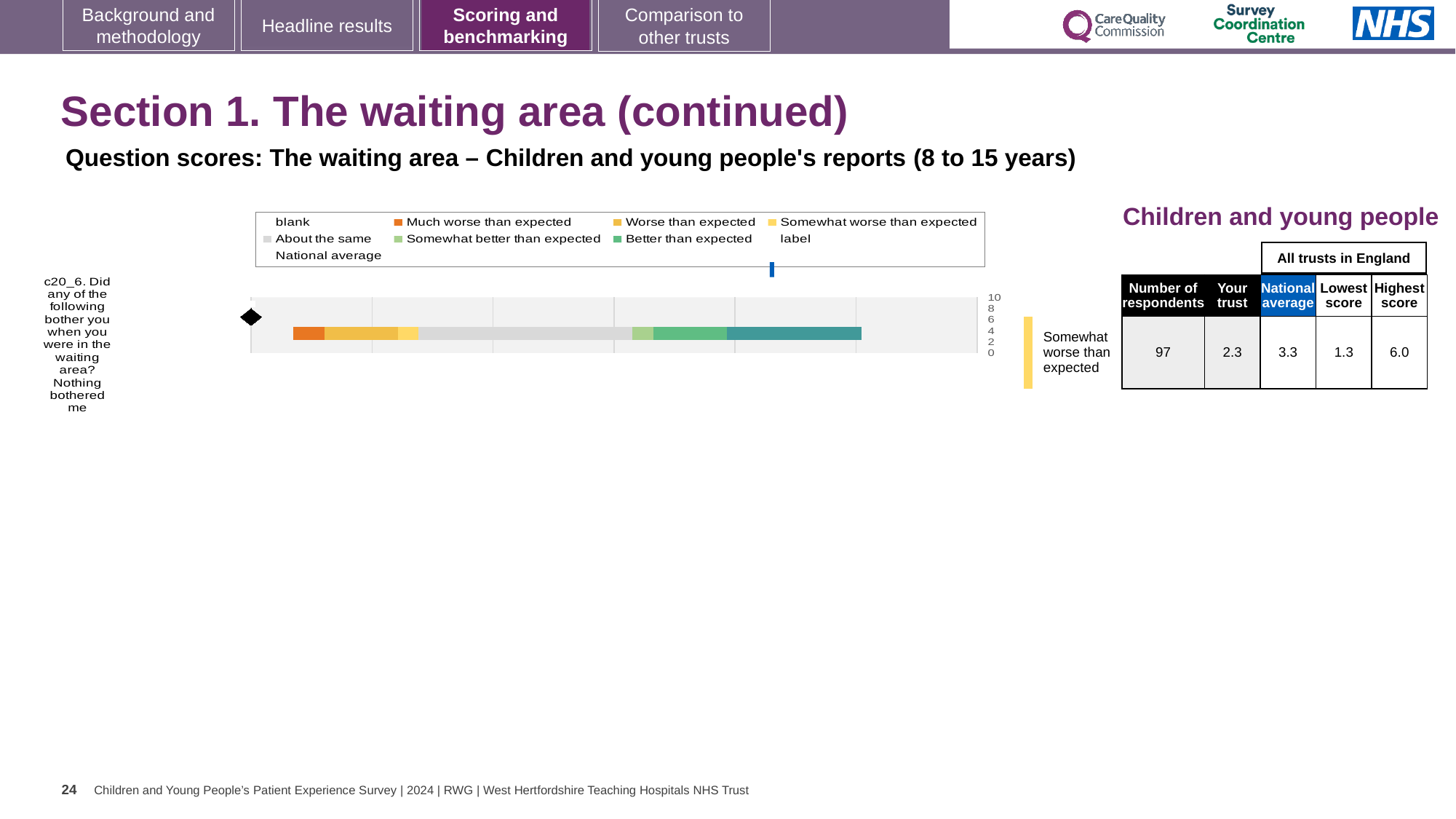
Which legend entry is shown in orange? Much worse than expected Which is larger for question c20_6: the trust's score or the national average? national average What is the difference between the national average (3.3) and the trust's score (2.3) for question c20_6? 1.0 How many survey questions are plotted in the chart? 1 What is the national average score for question c20_6 shown on the slide? 3.3 How many entries does the chart legend list? 9 What is the score for 'Your trust' for question c20_6 shown on the slide? 2.3 What is the lowest score across all trusts in England for question c20_6? 1.3 What kind of chart is shown on the slide? bar chart How many respondents answered question c20_6? 97 What is the highest score across all trusts in England for question c20_6? 6.0 Which question code is plotted in the chart? c20_6